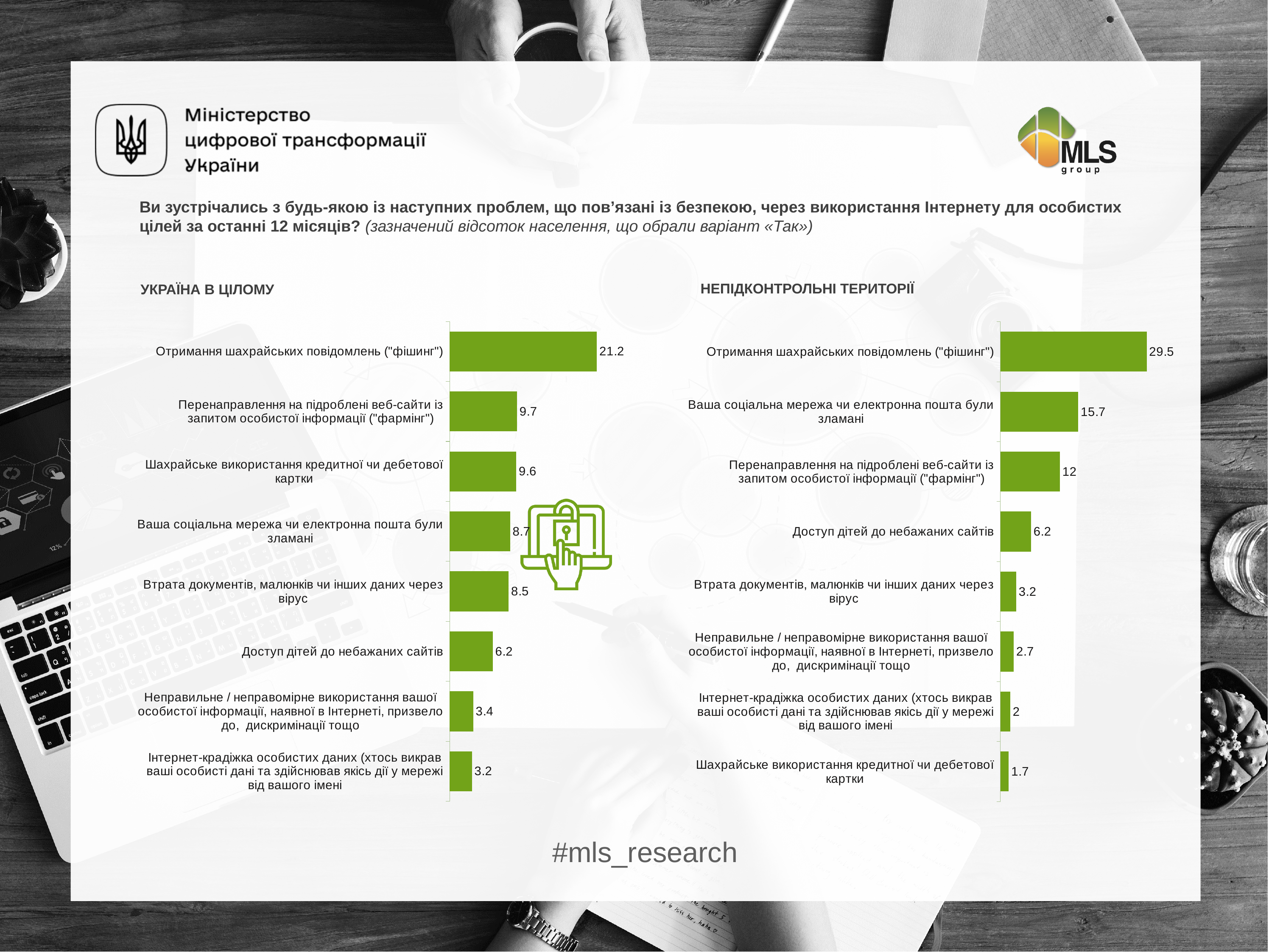
What colour are the bars in the "УКРАЇНА В ЦІЛОМУ" chart? Green What kind of chart is the "НЕПІДКОНТРОЛЬНІ ТЕРИТОРІЇ" chart? Bar chart In the "УКРАЇНА В ЦІЛОМУ" chart, which category has the lowest value? Інтернет-крадіжка особистих даних (хтось викрав ваші особисті дані та здійснював якісь дії у мережі від вашого імені) In the "НЕПІДКОНТРОЛЬНІ ТЕРИТОРІЇ" chart, what is the difference between the values for Отримання шахрайських повідомлень ("фішинг") and Перенаправлення на підроблені веб-сайти ("фармінг")? 17.5 In the "НЕПІДКОНТРОЛЬНІ ТЕРИТОРІЇ" chart, which category has the lowest value? Шахрайське використання кредитної чи дебетової картки How many categories are shown in the "УКРАЇНА В ЦІЛОМУ" chart? 8 In the "УКРАЇНА В ЦІЛОМУ" chart, what is the value for Доступ дітей до небажаних сайтів? 6.2 In the "НЕПІДКОНТРОЛЬНІ ТЕРИТОРІЇ" chart, which category has the highest value? Отримання шахрайських повідомлень ("фішинг") In the "УКРАЇНА В ЦІЛОМУ" chart, what is the difference between the values for Отримання шахрайських повідомлень ("фішинг") and Перенаправлення на підроблені веб-сайти ("фармінг")? 11.5 In the "НЕПІДКОНТРОЛЬНІ ТЕРИТОРІЇ" chart, what is the value for Ваша соціальна мережа чи електронна пошта були зламані? 15.7 Which is larger: the value for Шахрайське використання кредитної чи дебетової картки in the "УКРАЇНА В ЦІЛОМУ" chart or in the "НЕПІДКОНТРОЛЬНІ ТЕРИТОРІЇ" chart? УКРАЇНА В ЦІЛОМУ In the "УКРАЇНА В ЦІЛОМУ" chart, what is the value for Отримання шахрайських повідомлень ("фішинг")? 21.2